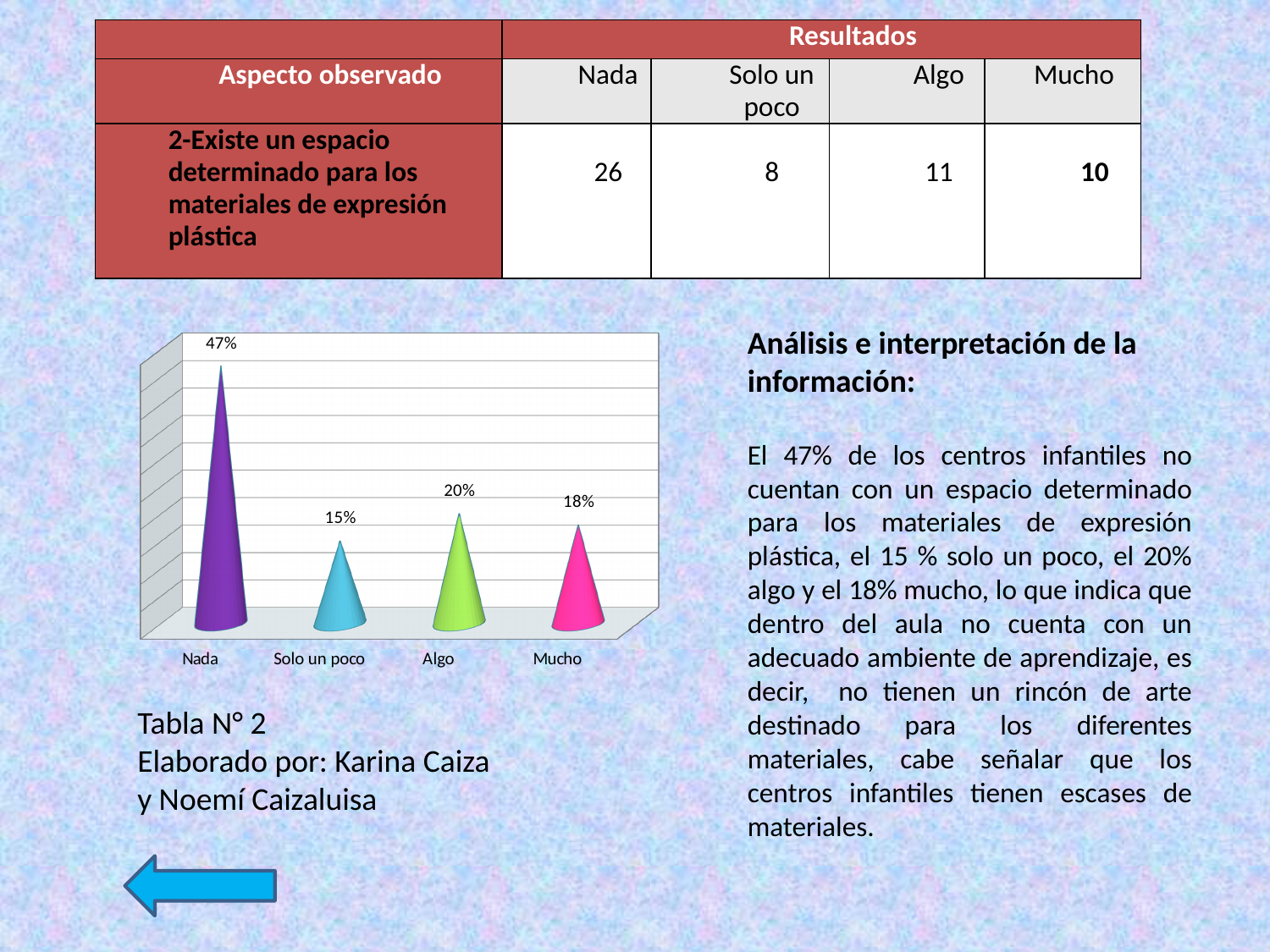
What is the value shown for Algo in the chart? 20% How many categories are shown in the chart? 4 What is the value shown for Mucho in the chart? 18% What is the difference between the values for Nada and Algo in the chart? 27% Which category has the highest value in the chart? Nada What is the value shown for Solo un poco in the chart? 15% Which is larger in the chart, the value for Algo or the value for Mucho? Algo Which category has the lowest value in the chart? Solo un poco What is the value shown for Nada in the chart? 47% What is the difference between the values for Mucho and Solo un poco in the chart? 3% What kind of chart is shown on the slide? Bar chart What colour is the bar for Nada in the chart? Purple